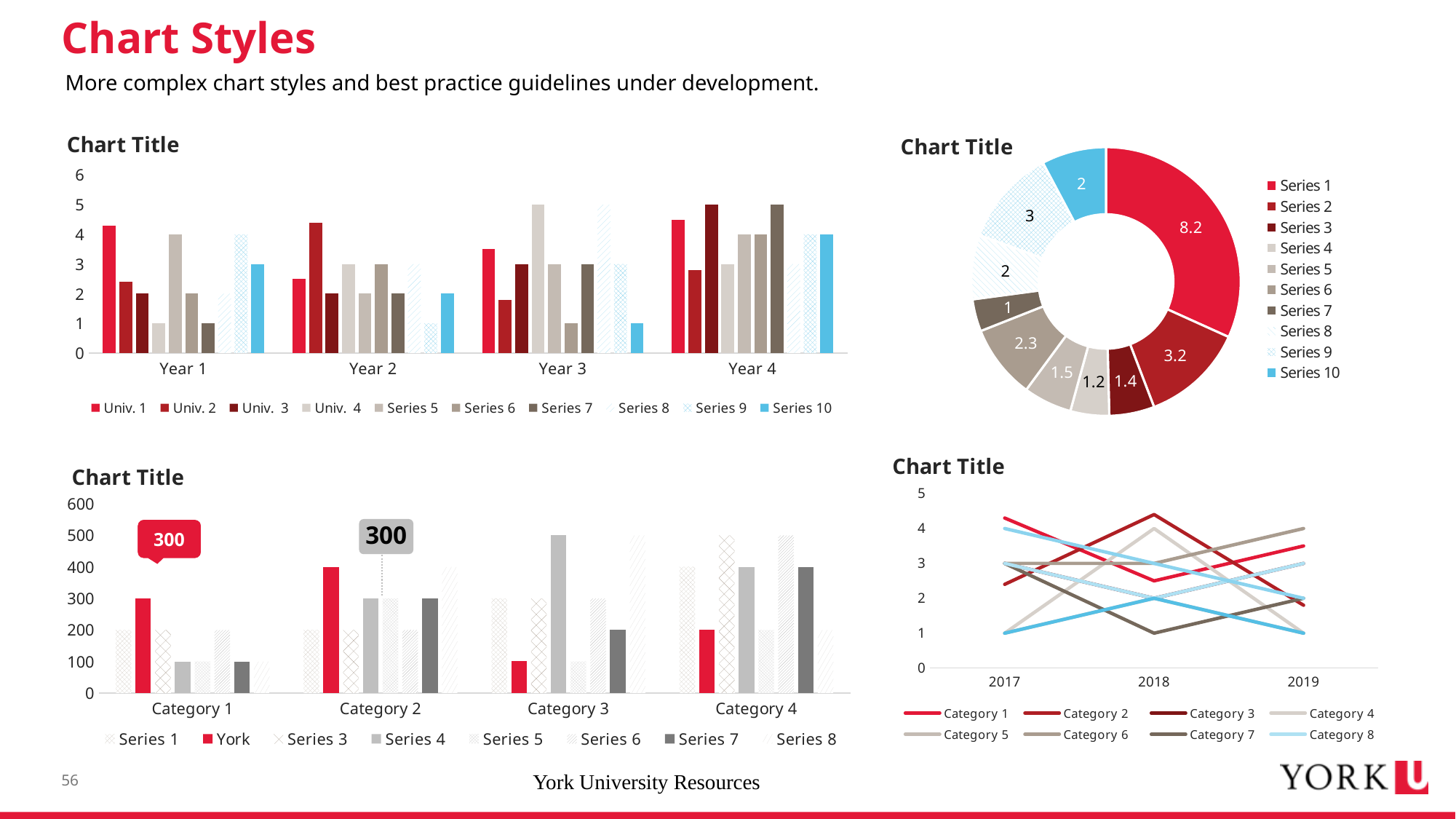
In the bottom-left bar chart, what is the value for York in Category 1? 300 In the top-right doughnut chart, what is the value for Series 1? 8.2 In the bottom-left bar chart, how many series does the legend list? 8 What kind of chart is the top-left chart on the slide? bar chart In the top-left bar chart, how many series does the legend list? 10 In the top-left bar chart, how many categories are shown on the x axis? 4 In the top-right doughnut chart, which series has the smallest value? Series 7 In the top-left bar chart, is the value for Univ. 1 in Year 1 greater or less than 3? greater In the top-right doughnut chart, what is the difference between the values for Series 1 and Series 2? 5 In the bottom-right line chart, how many points are shown on the x axis? 3 In the top-right doughnut chart, which series has the largest value? Series 1 In the bottom-left bar chart, is the value for York larger in Category 2 or Category 3? Category 2